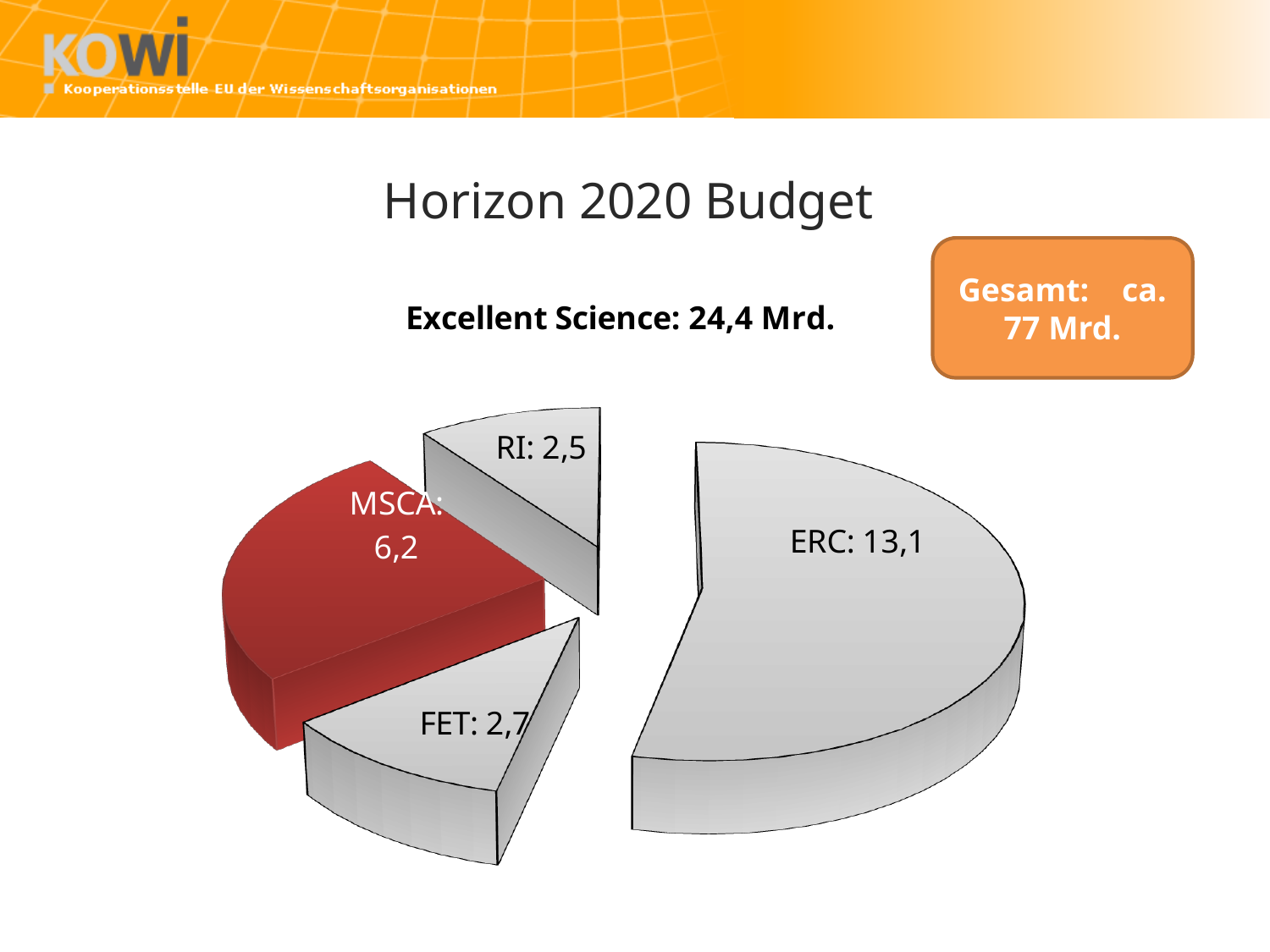
What is the difference between the ERC value and the MSCA value? 6,9 What is the difference between the MSCA value and the RI value? 3,7 What is the value shown for ERC in the pie chart? 13,1 What is the value shown for MSCA in the pie chart? 6,2 Which slice of the pie chart has the smallest value? RI Which slice of the pie chart has the largest value? ERC Which is larger, the value for FET or the value for RI? FET How many slices does the pie chart have? 4 Which slice of the pie chart is coloured red? MSCA What kind of chart is shown on the slide? Pie chart What is the value shown for RI in the pie chart? 2,5 What is the value shown for FET in the pie chart? 2,7